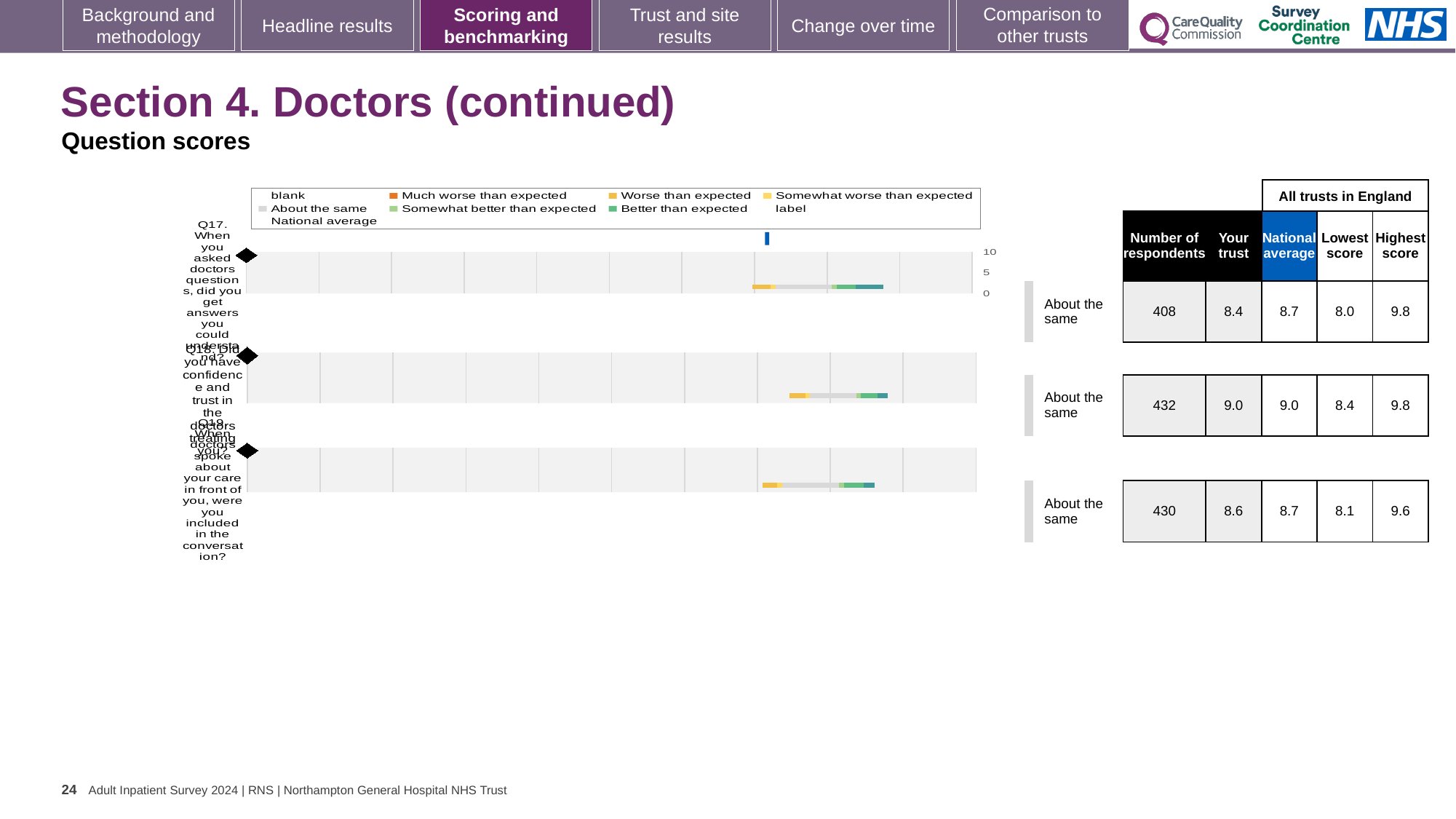
Is the 'Your trust' score higher for Q18 or Q19? Q18 What is the lowest score across all trusts in England for Q17? 8.0 Which question has the fewest respondents? Q17 What is the highest score across all trusts in England for Q19? 9.6 What type of chart is used to show the question scores on this slide? bar chart What is the difference between the national average and the 'Your trust' score for Q17? 0.3 What is the national average score for Q18? 9.0 What is the 'Your trust' score for Q17? 8.4 Which question has the highest 'Your trust' score? Q18 What benchmark category is shown for Q17? About the same How many respondents answered Q19? 430 How many questions (categories) are plotted in the chart? 3